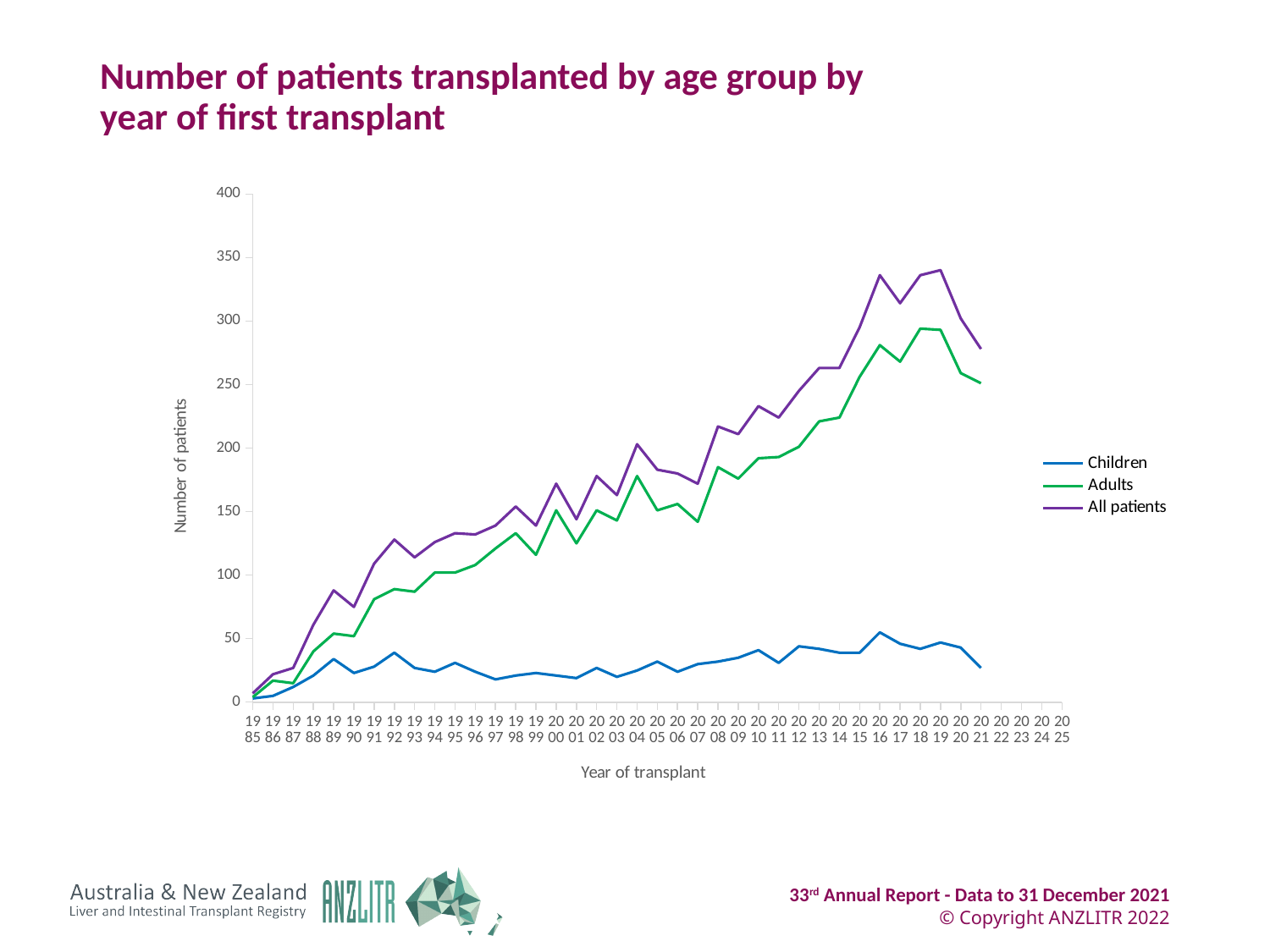
Which series has the larger value in 2021, Adults or Children? Adults Is the value for Adults in 2010 greater or less than 150? greater In which year does the Children series reach its highest value? 2016 Is the value for All patients in 1985 greater or less than 50? less How many series does the legend list? 3 What are the three series named in the legend? Children, Adults, All patients Is the value for Children in 2021 greater or less than 50? less What kind of chart is shown on the slide? Line chart What is the label of the y axis? Number of patients Does the All patients series generally rise or fall from 1985 to 2019? rise Which series has the lowest values across all years? Children